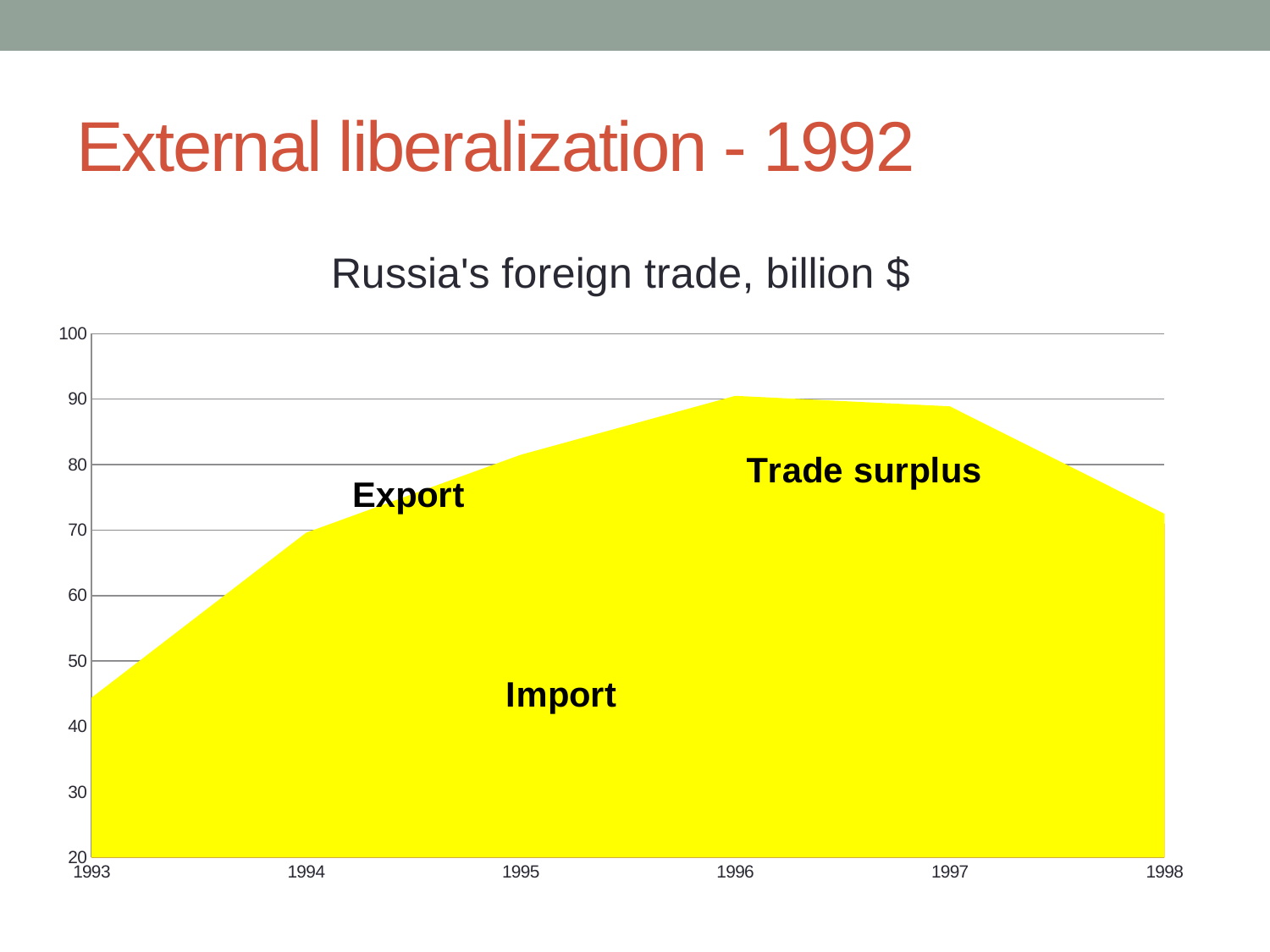
Is the value for 1993 greater or less than 50? less Do the values rise or fall from 1993 to 1996? rise Which is larger, the value for 1993 or the value for 1994? 1994 What is the title of the chart? Russia's foreign trade, billion $ Which year has the lowest value in the chart? 1993 Is the value for 1998 greater or less than 80? less Is the value for 1994 greater or less than 60? greater What kind of chart is shown on the slide? area chart Do the values rise or fall from 1996 to 1998? fall How many years are shown on the x axis of the chart? 6 Which is larger, the value for 1996 or the value for 1998? 1996